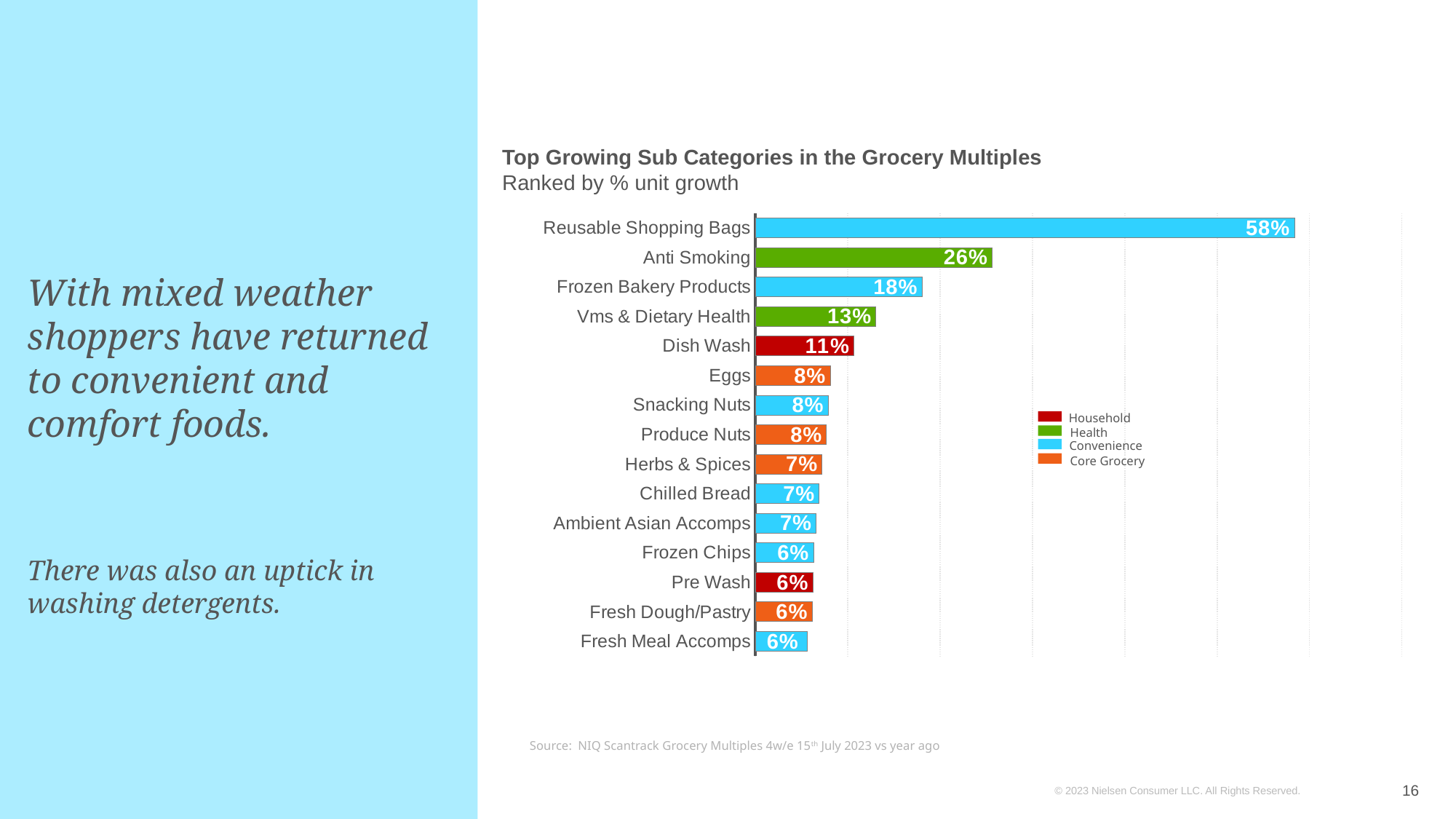
How many sub categories are shown in the chart? 15 What is the difference in % unit growth between Reusable Shopping Bags and Anti Smoking? 32% What type of chart is shown on the slide? Bar chart What is the % unit growth for Dish Wash? 11% What is the difference in % unit growth between Frozen Bakery Products and Vms & Dietary Health? 5% Which has a higher % unit growth, Anti Smoking or Frozen Bakery Products? Anti Smoking Which has a higher % unit growth, Dish Wash or Eggs? Dish Wash Which sub category has the highest % unit growth? Reusable Shopping Bags How many series does the legend list? 4 What is the % unit growth for Reusable Shopping Bags? 58% What is the % unit growth for Herbs & Spices? 7% What is the % unit growth for Anti Smoking? 26%